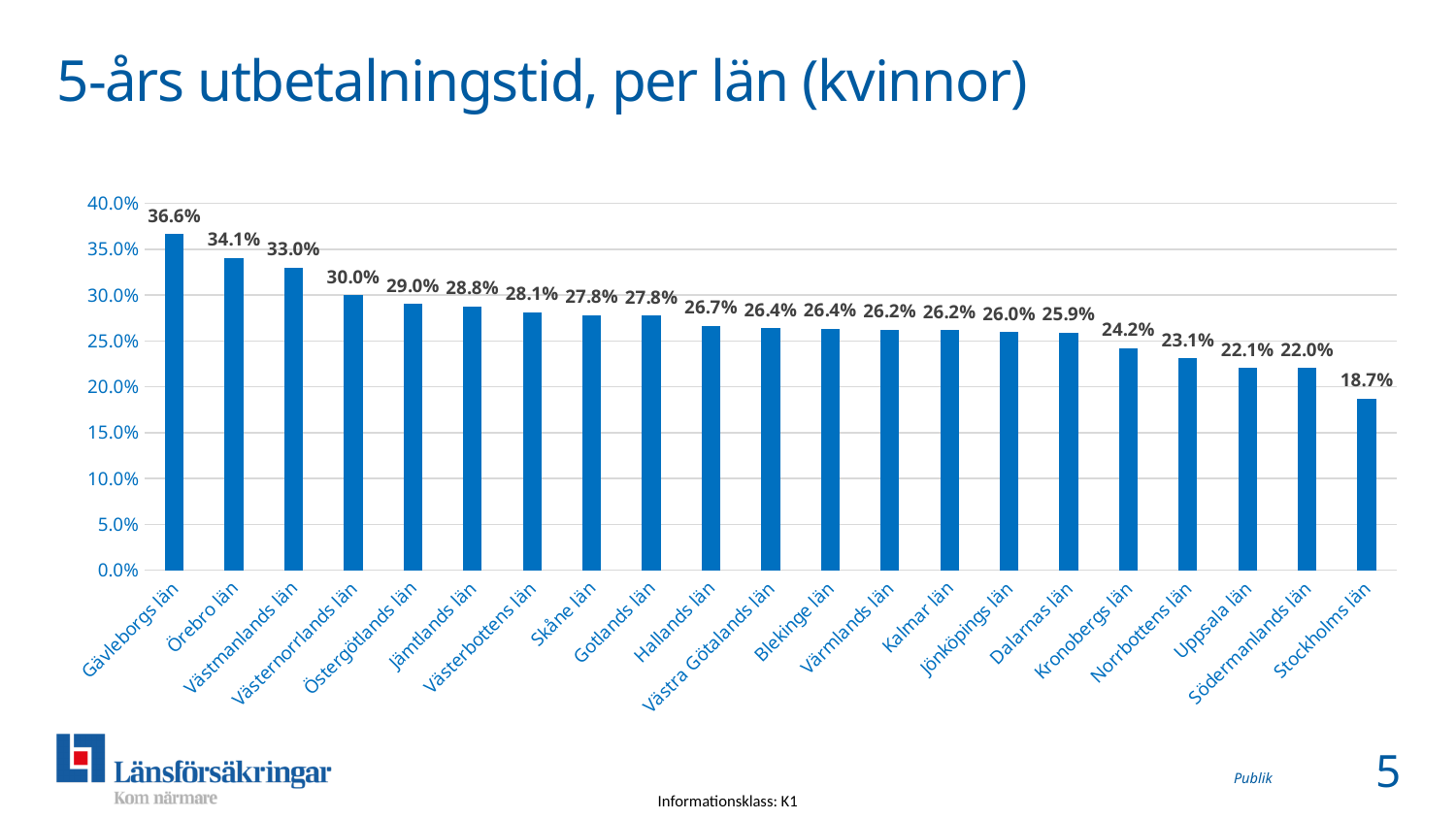
Do the values rise or fall from left to right along the x axis? Fall What is the value for Stockholms län? 18.7% What is the value for Gävleborgs län? 36.6% How many counties are shown in the chart? 21 Which is larger, the value for Västernorrlands län or the value for Uppsala län? Västernorrlands län What is the difference between the values for Gävleborgs län and Stockholms län? 17.9% What is the value for Hallands län? 26.7% What kind of chart is shown on the slide? Bar chart What is the difference between the values for Örebro län and Västmanlands län? 1.1% Which county has the lowest value? Stockholms län Which county has the highest value? Gävleborgs län What is the value for Kronobergs län? 24.2%